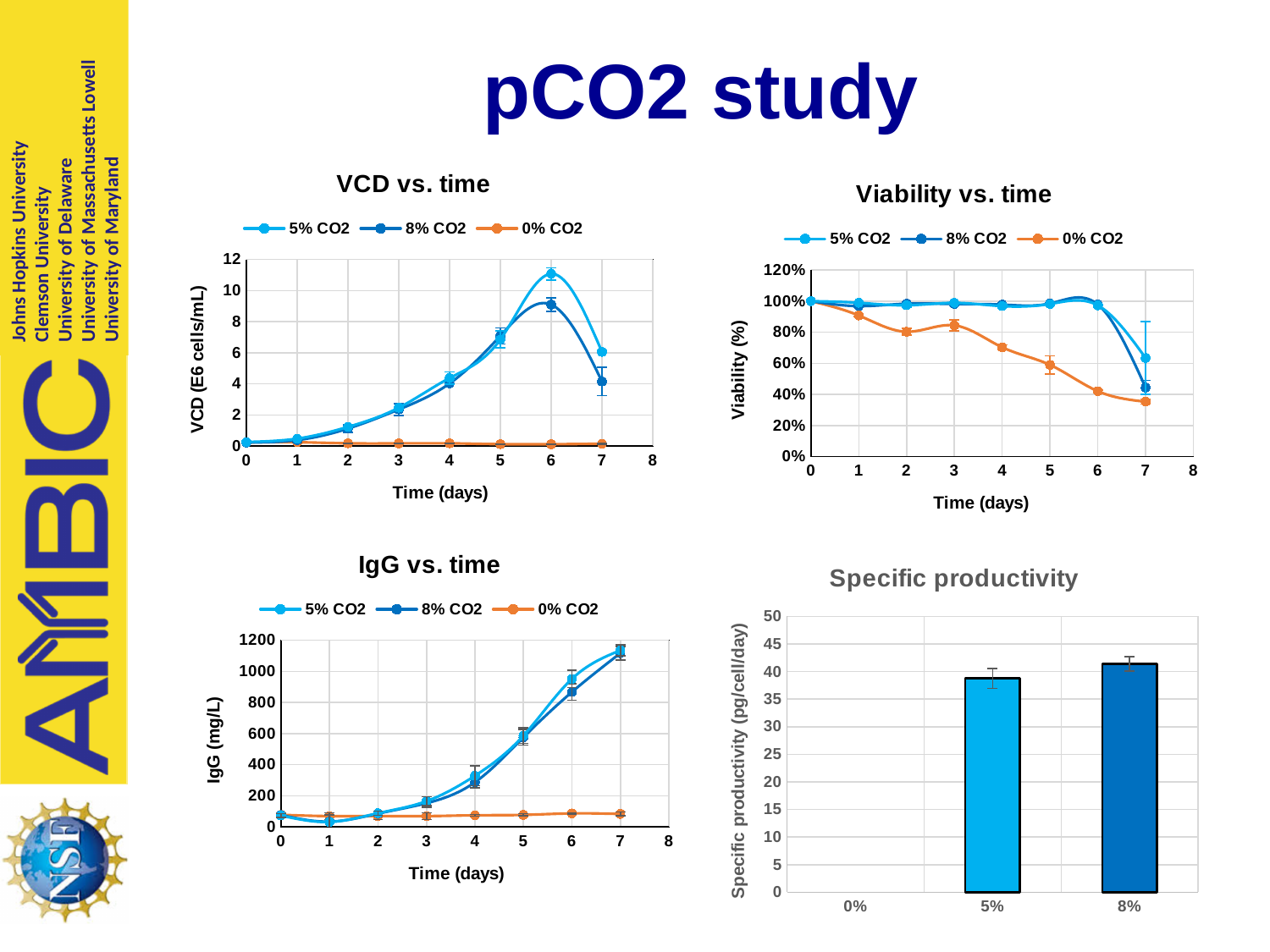
In the VCD vs. time chart, how many series does the legend list? 3 What is the y-axis label of the Specific productivity chart? Specific productivity (pg/cell/day) In the Viability vs. time chart, is the value for 0% CO2 at day 4 greater or less than 60%? greater In the Viability vs. time chart, which series has the lowest viability at day 4? 0% CO2 In the Specific productivity chart, is the value for 5% greater or less than 35? greater In the IgG vs. time chart, does the 5% CO2 series rise or fall from day 3 to day 7? rise In the VCD vs. time chart, is the value for 5% CO2 at day 6 greater or less than 10? greater What kind of chart is the Specific productivity chart? bar chart In the Specific productivity chart, which is larger, the value for 5% or the value for 8%? 8% What kind of chart is the VCD vs. time chart? line chart In the VCD vs. time chart, which series reaches the highest VCD? 5% CO2